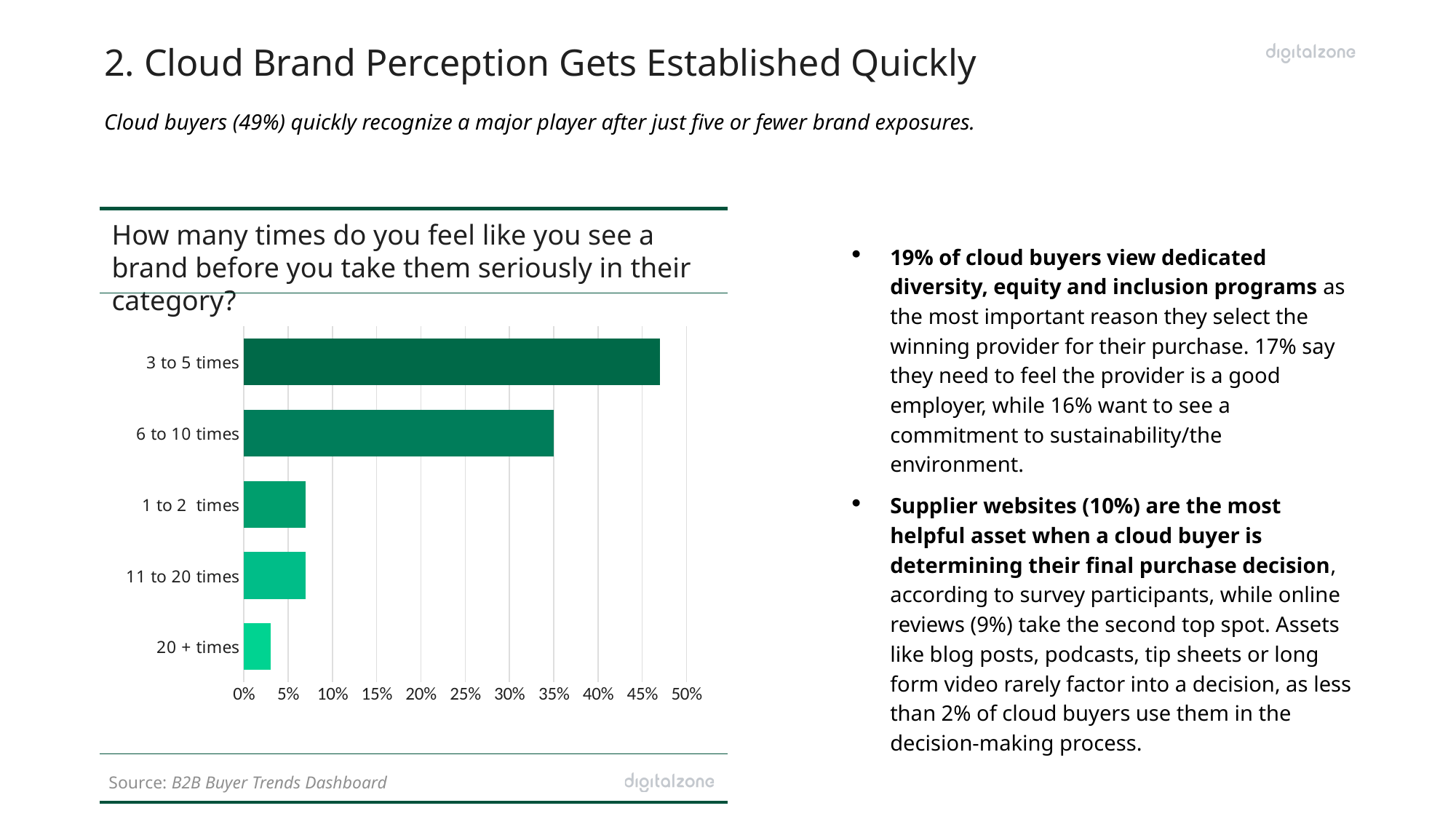
What source is cited for the chart? B2B Buyer Trends Dashboard Is the value for 6 to 10 times greater or less than 30%? greater Is the value for 3 to 5 times greater or less than 45%? greater Is the value for 20 + times greater or less than 5%? less Which category has the highest value? 3 to 5 times Which is larger, the value for 3 to 5 times or the value for 6 to 10 times? 3 to 5 times Which category has the lowest value? 20 + times What question is the chart titled with? How many times do you feel like you see a brand before you take them seriously in their category? How many categories does the chart show? 5 Which is larger, the value for 6 to 10 times or the value for 1 to 2 times? 6 to 10 times What kind of chart is shown on the slide? bar chart